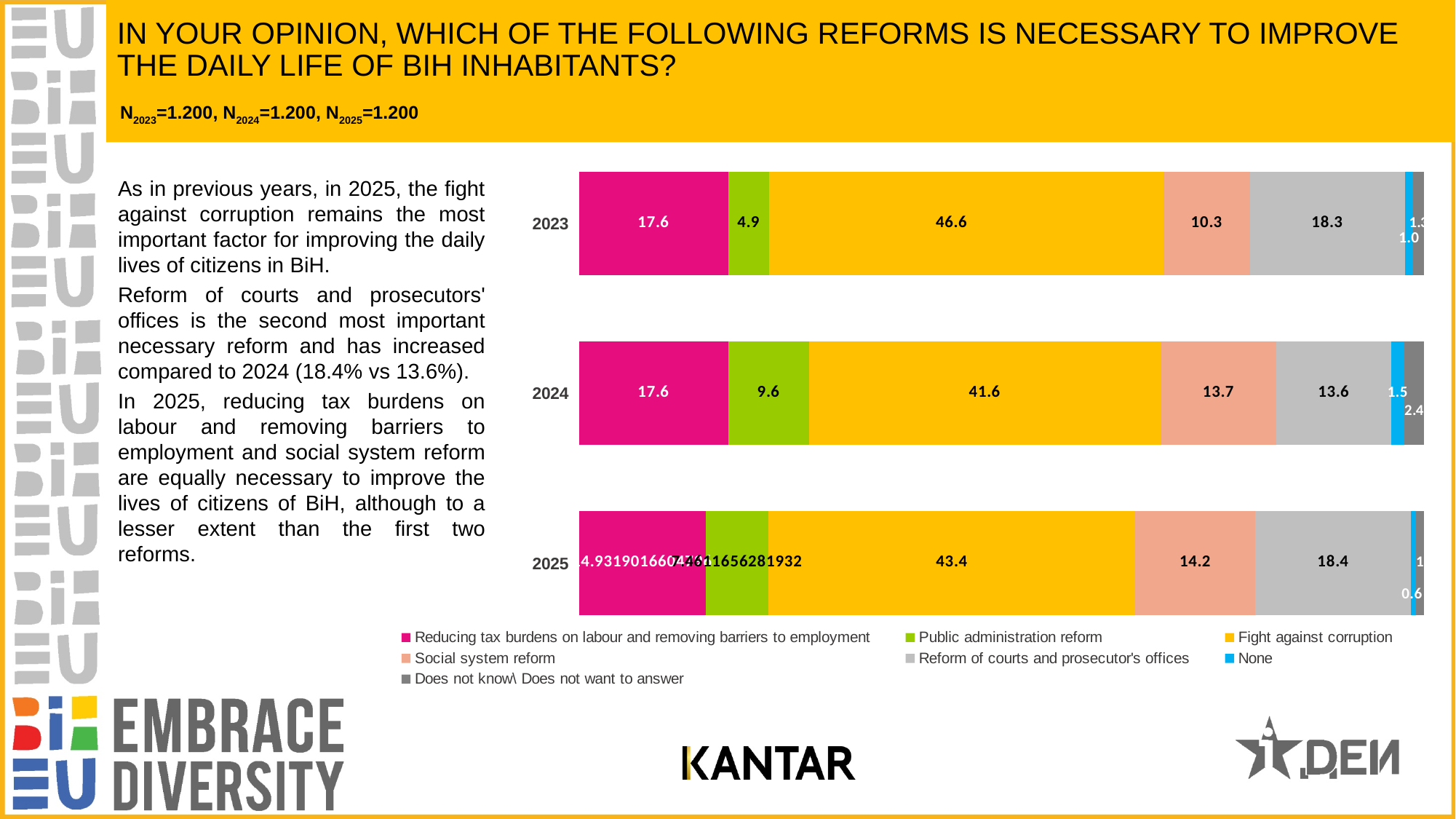
What is the difference between the Public administration reform values in 2024 and 2023? 4.7 What is the value for Reform of courts and prosecutor's offices in 2025? 18.4 What is the difference between the Reform of courts and prosecutor's offices values in 2025 and 2024? 4.8 What is the value for Does not know\ Does not want to answer in 2024? 2.4 How many years are shown in the chart? 3 What kind of chart is shown on the slide? Stacked bar chart How many series does the legend list? 7 Which year has the larger value for Social system reform, 2023 or 2024? 2024 What is the value for Fight against corruption in 2023? 46.6 What is the value for Public administration reform in 2024? 9.6 In which year is the value for Fight against corruption the highest? 2023 What is the value for Social system reform in 2025? 14.2